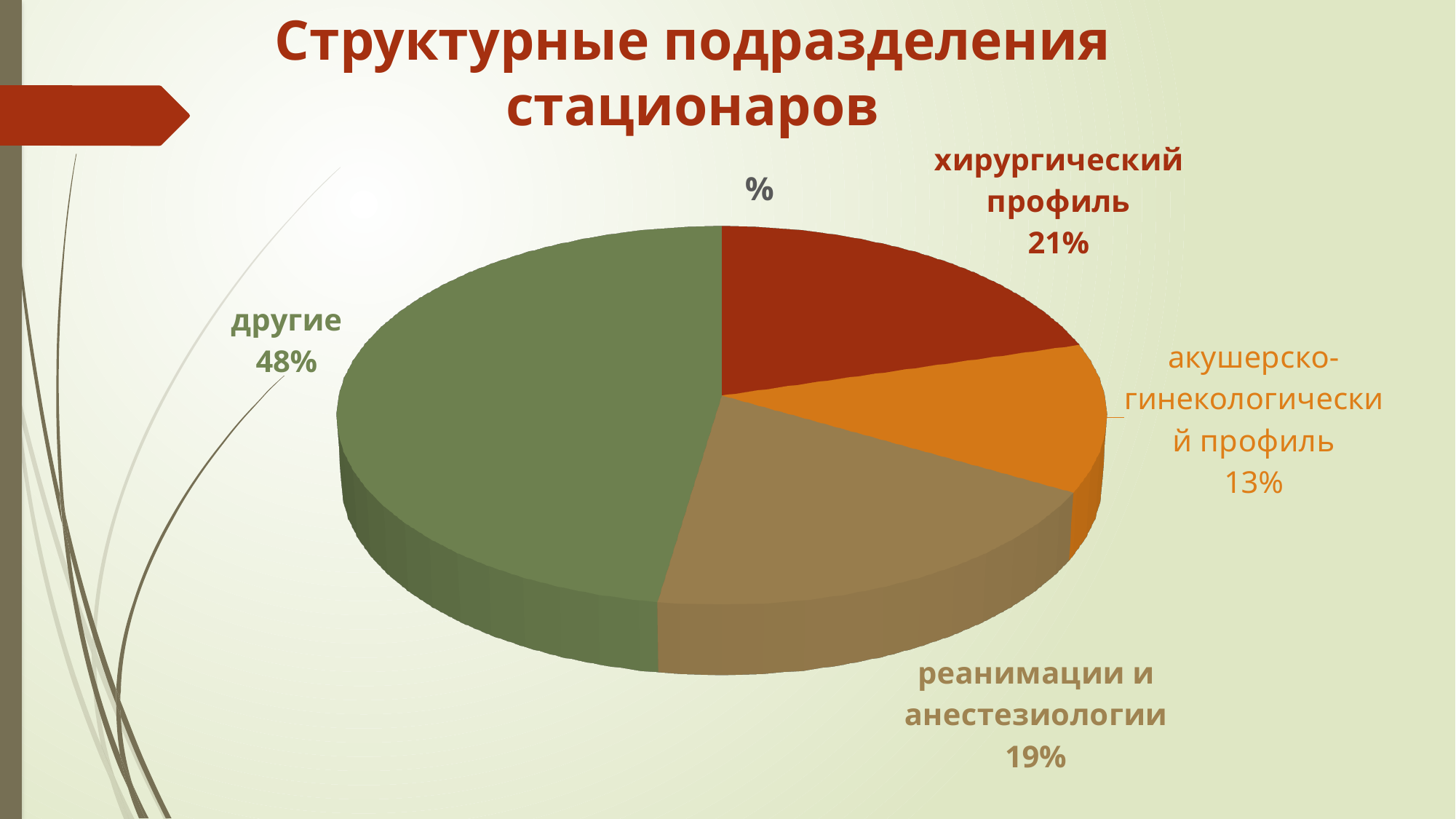
What is the difference between the shares of "хирургический профиль" and "акушерско-гинекологический профиль"? 8% What share of the pie does the slice "другие" have? 48% How many slices does the pie chart have? 4 What is the title of the slide containing the pie chart? Структурные подразделения стационаров Which slice of the pie is the smallest? акушерско-гинекологический профиль What share of the pie does the slice "акушерско-гинекологический профиль" have? 13% What is the difference between the shares of "другие" and "реанимации и анестезиологии"? 29% Which is larger: the share of "хирургический профиль" or the share of "реанимации и анестезиологии"? хирургический профиль Which slice of the pie is the largest? другие What kind of chart is shown on the slide? Pie chart What share of the pie does the slice "реанимации и анестезиологии" have? 19%